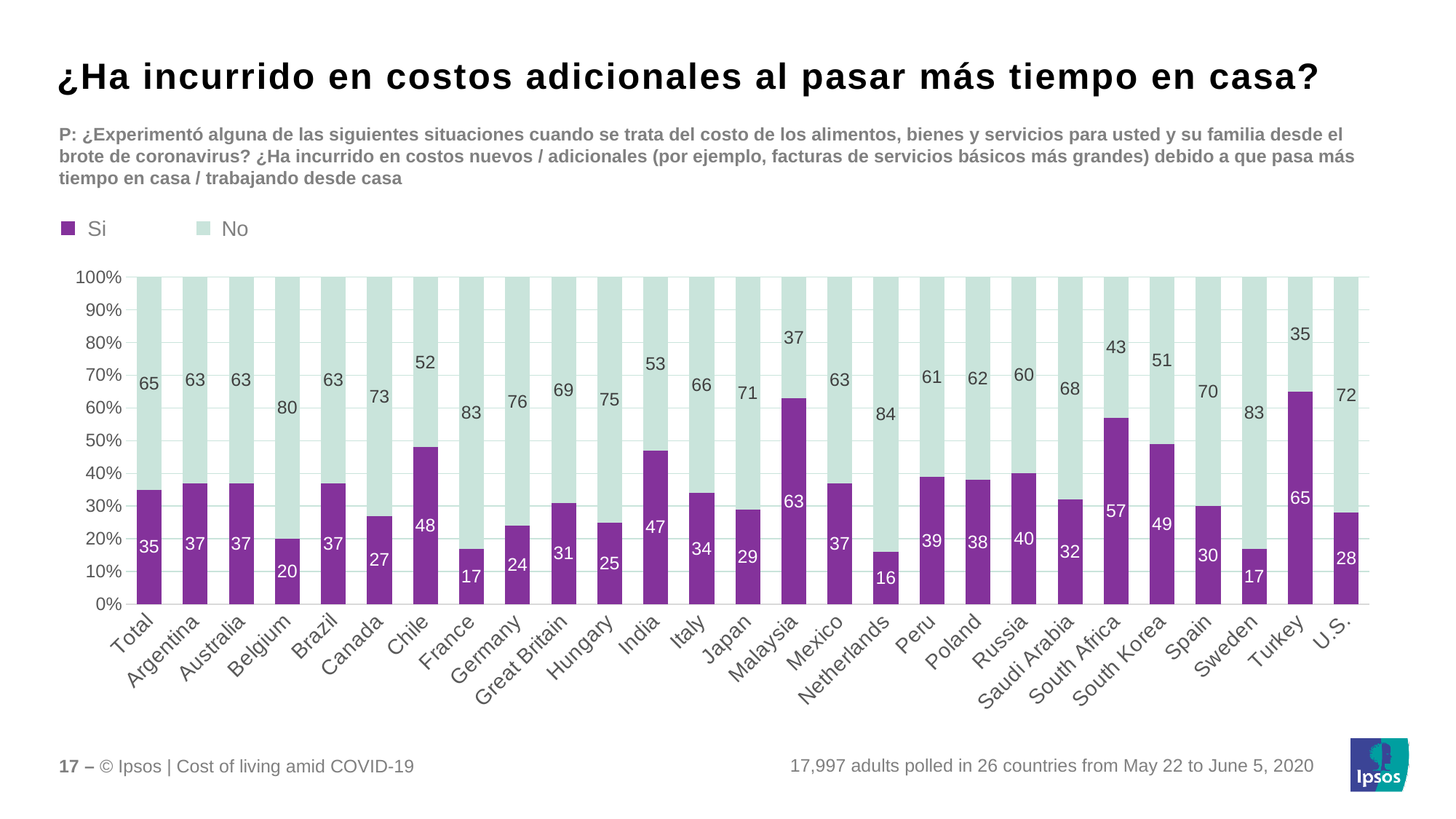
What kind of chart is shown on the slide? Stacked bar chart What is the difference between the 'Si' values for Malaysia and India? 16 Which country has the highest 'Si' value? Turkey Which has a larger 'Si' value, South Africa or South Korea? South Africa How many series does the legend list? 2 Is the 'Si' bar for Belgium greater or less than 30%? less What is the total of the stacked bar for Japan? 100 What is the 'Si' value for Total? 35 What is the 'Si' value for Chile? 48 How many categories are shown on the x axis? 27 Which country has the lowest 'Si' value? Netherlands What is the 'No' value for Netherlands? 84